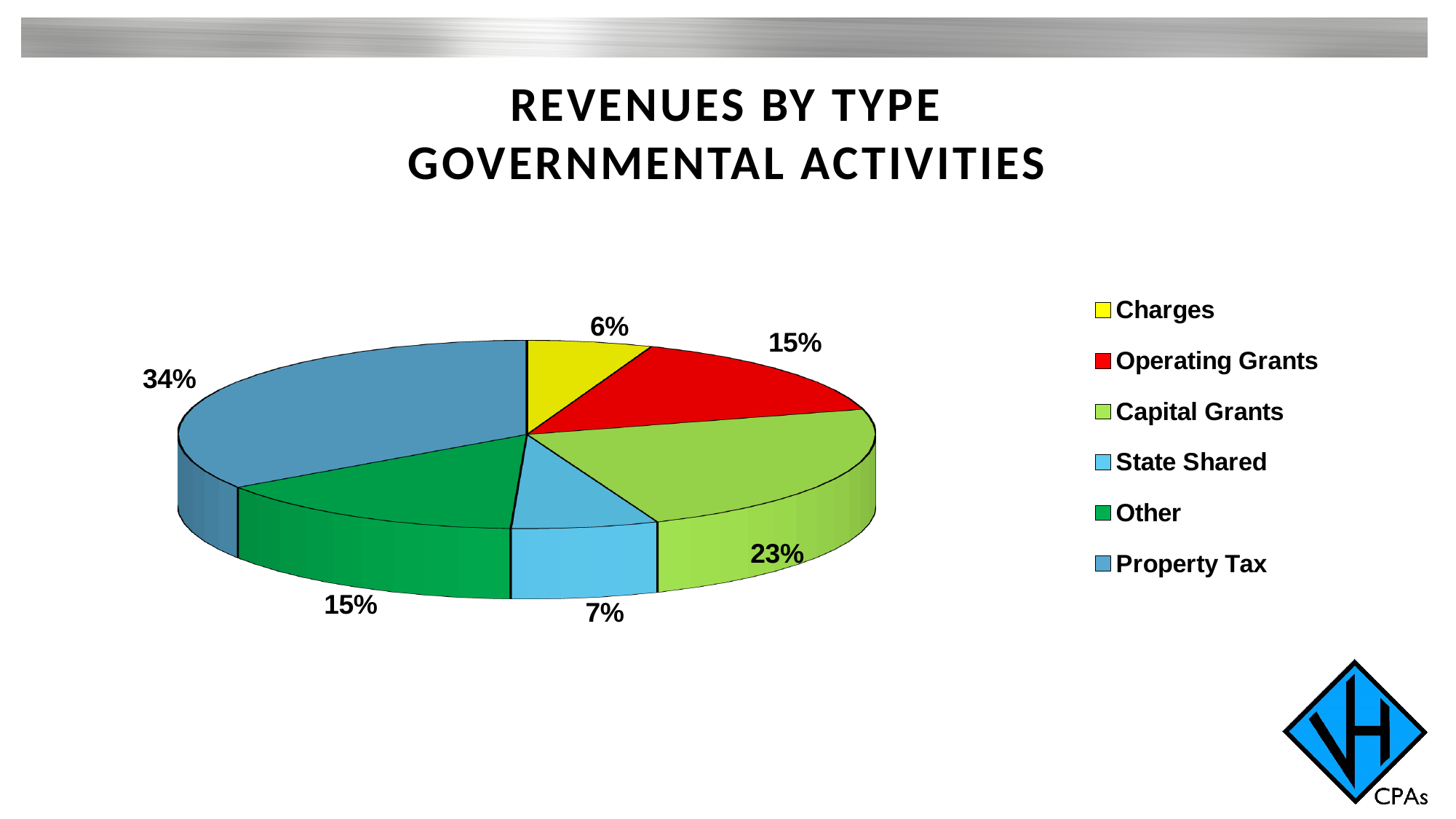
What colour is the Operating Grants slice? Red Which revenue type has the largest share? Property Tax What kind of chart is shown on the slide? Pie chart Which revenue type has the smallest share? Charges What share of revenues does Property Tax represent? 34% What share of revenues does Capital Grants represent? 23% What share of revenues does Charges represent? 6% What is the difference in percentage points between Property Tax and Capital Grants? 11 What share of revenues does Operating Grants represent? 15% How many revenue types are shown in the pie chart? 6 What share of revenues does State Shared represent? 7% Which is larger, the share for Capital Grants or the share for Other? Capital Grants